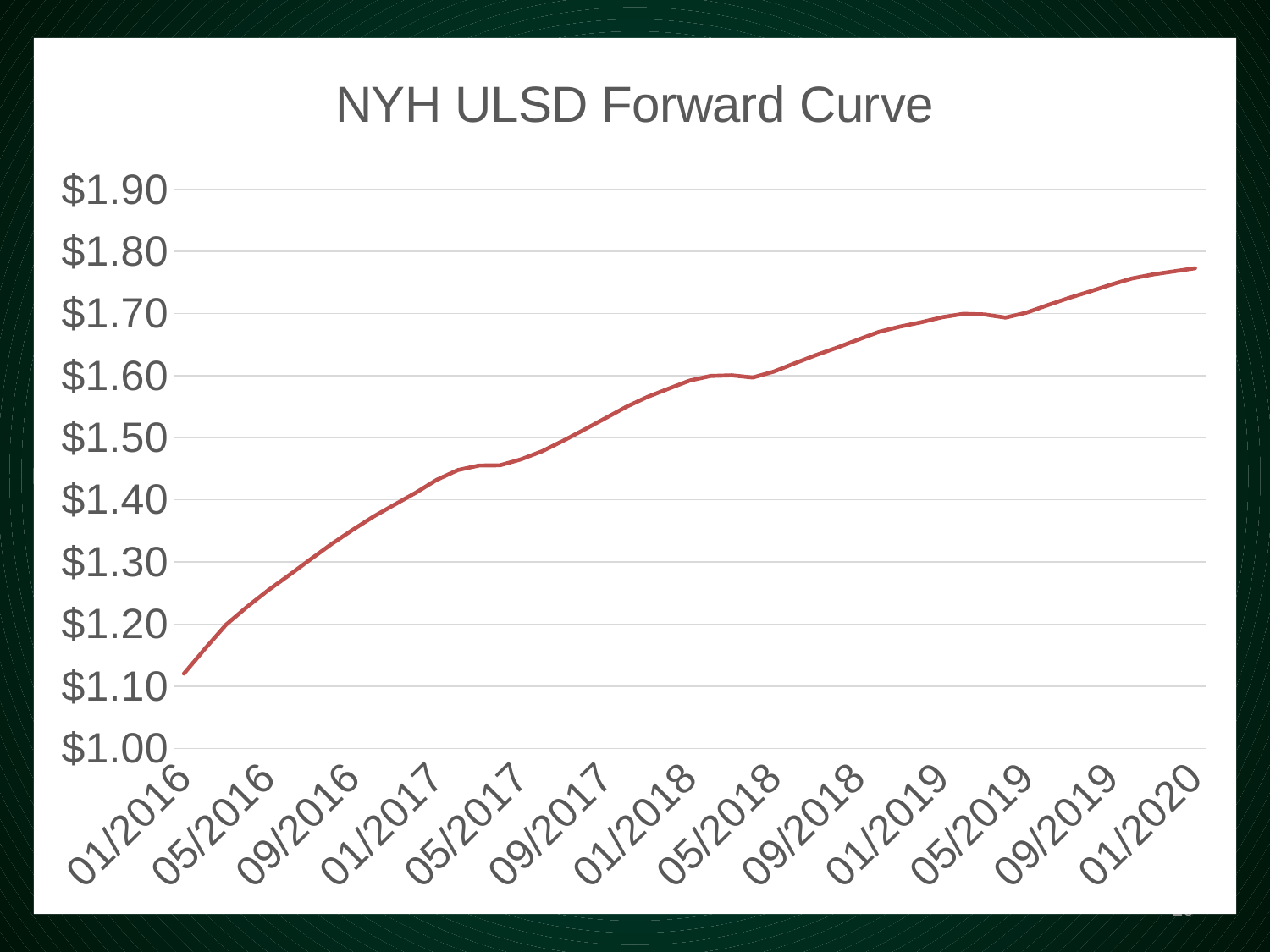
Is the value at 09/2016 greater or less than $1.30? greater Do the values generally rise or fall from 01/2016 to 01/2020? rise At which x-axis date does the line have its lowest value? 01/2016 What is the title of the chart? NYH ULSD Forward Curve At which x-axis date does the line reach its highest value? 01/2020 Is the value at 01/2016 greater or less than $1.20? less How many date labels are shown on the x axis? 13 Is the value at 01/2020 greater or less than $1.70? greater Which is larger, the value at 01/2019 or the value at 01/2017? 01/2019 What kind of chart is shown on the slide? line chart